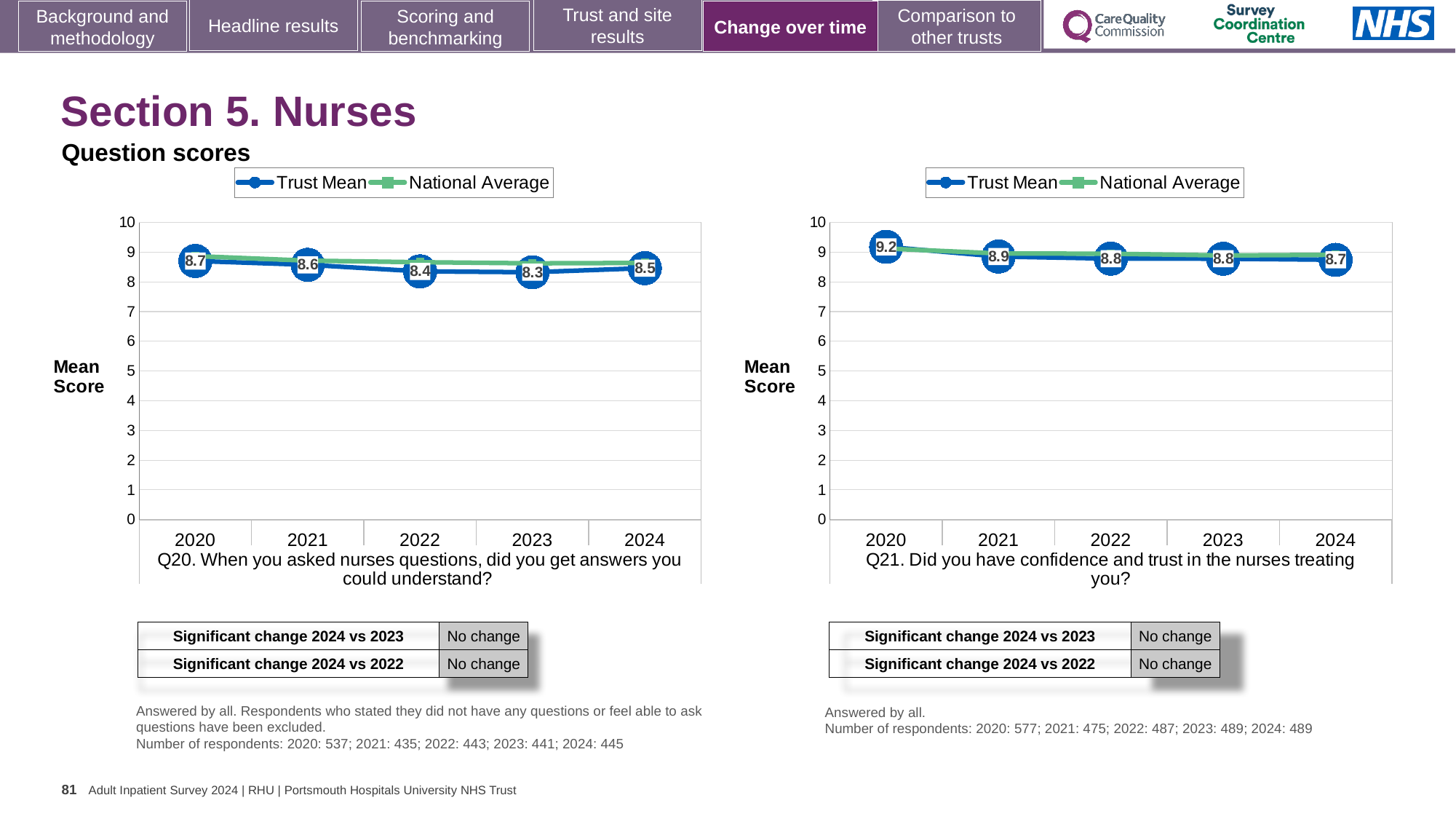
In the Q21 chart, what is the Trust Mean score for 2020? 9.2 In the Q20 chart, what is the Trust Mean score for 2023? 8.3 What kind of chart is used for Q20? Line chart In the Q20 chart, which year has the lowest Trust Mean score? 2023 How many years are shown on the x axis of the Q20 chart? 5 In the Q20 chart, what is the difference between the Trust Mean scores for 2020 and 2023? 0.4 In the Q21 chart, what is the difference between the Trust Mean scores for 2020 and 2024? 0.5 In the Q21 chart, what is the Trust Mean score for 2024? 8.7 In the Q21 chart, is the Trust Mean score for 2020 greater or less than 9? greater How many series does the legend of the Q21 chart list? 2 In the Q20 chart, what is the Trust Mean score for 2020? 8.7 In the Q21 chart, which year has the highest Trust Mean score? 2020